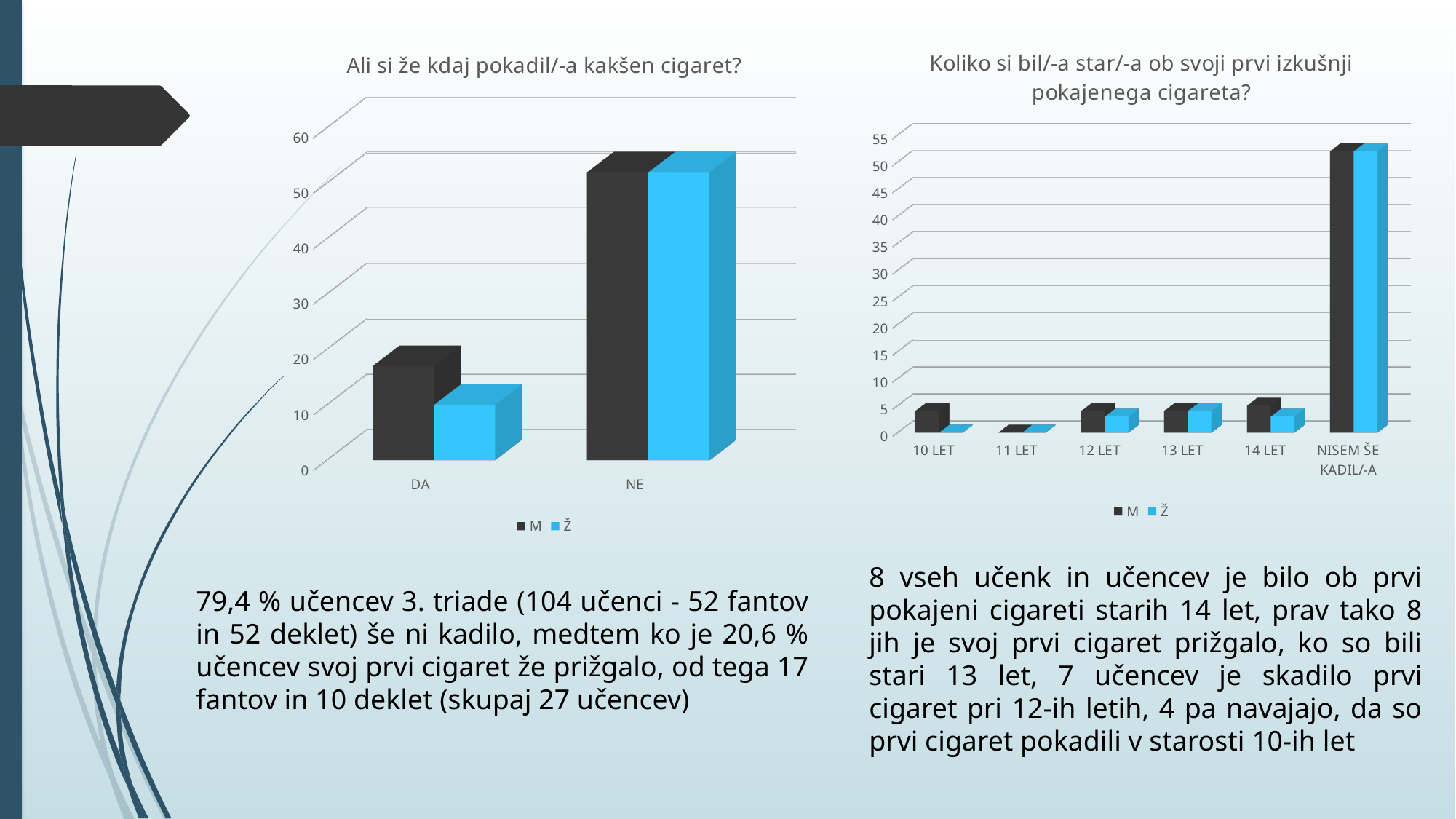
In the left chart 'Ali si že kdaj pokadil/-a kakšen cigaret?', which category has the highest value for M? NE What kind of chart is the left chart titled 'Ali si že kdaj pokadil/-a kakšen cigaret?'? bar chart In the left chart 'Ali si že kdaj pokadil/-a kakšen cigaret?', is the value for Ž in the DA category greater or less than 20? less In the right chart 'Koliko si bil/-a star/-a ob svoji prvi izkušnji pokajenega cigareta?', what are the two series listed in the legend? M and Ž In the right chart 'Koliko si bil/-a star/-a ob svoji prvi izkušnji pokajenega cigareta?', is the value for M in the NISEM ŠE KADIL/-A category greater or less than 45? greater In the right chart 'Koliko si bil/-a star/-a ob svoji prvi izkušnji pokajenega cigareta?', is the value for Ž in the 10 LET category greater or less than 5? less In the left chart 'Ali si že kdaj pokadil/-a kakšen cigaret?', how many categories are shown on the x axis? 2 In the right chart 'Koliko si bil/-a star/-a ob svoji prvi izkušnji pokajenega cigareta?', how many categories are shown on the x axis? 6 In the right chart 'Koliko si bil/-a star/-a ob svoji prvi izkušnji pokajenega cigareta?', which category has the highest value for M? NISEM ŠE KADIL/-A In the left chart 'Ali si že kdaj pokadil/-a kakšen cigaret?', how many series does the legend list? 2 In the left chart 'Ali si že kdaj pokadil/-a kakšen cigaret?', which series has the larger value in the DA category, M or Ž? M